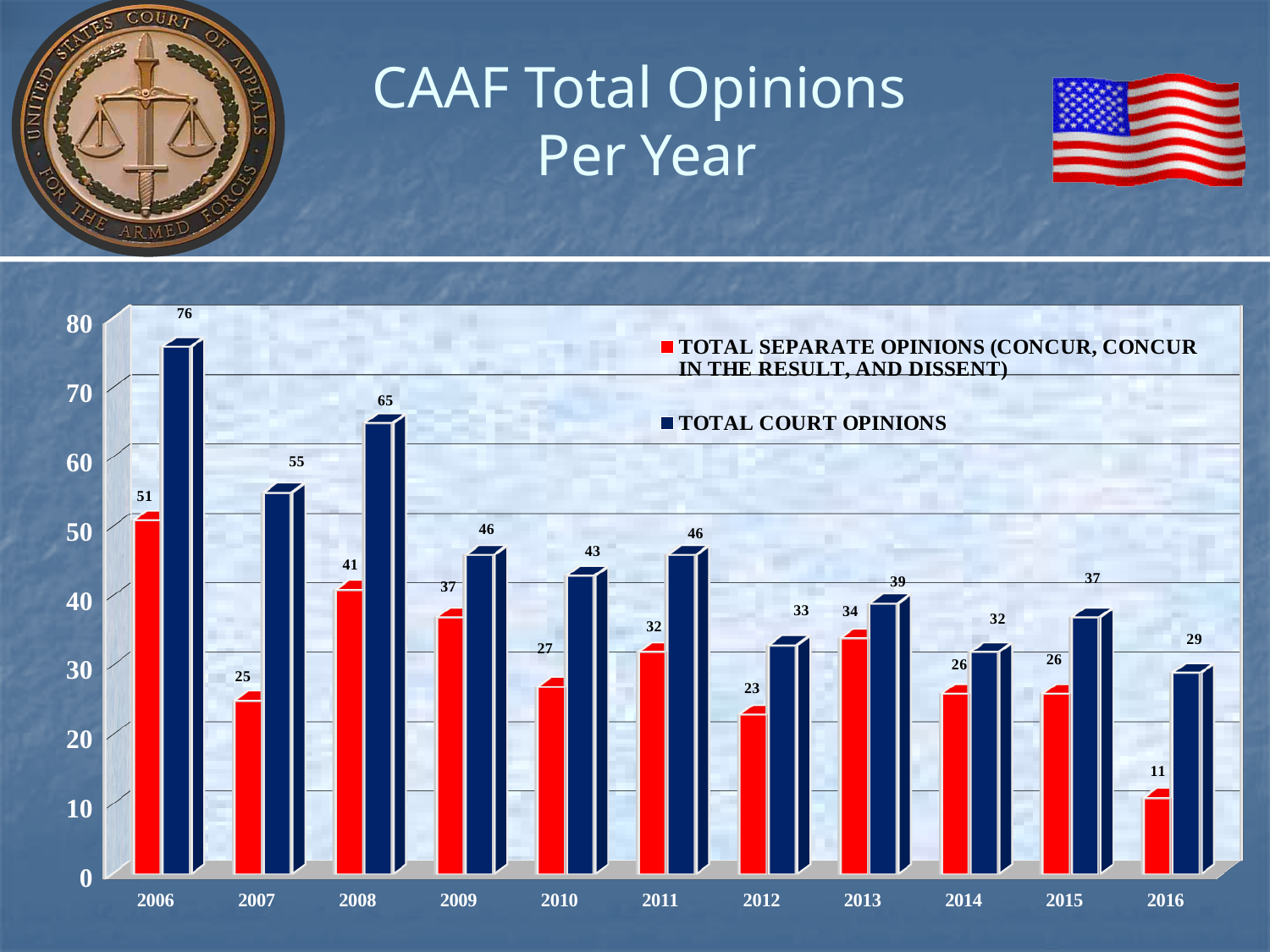
Which is larger: Total Court Opinions in 2010 or Total Court Opinions in 2012? 2010 Do Total Court Opinions generally rise or fall from 2006 to 2016? fall What is the value for Total Separate Opinions in 2016? 11 What kind of chart is shown on the slide? bar chart How many years are shown on the x axis? 11 What is the value for Total Separate Opinions in 2013? 34 What is the difference between Total Court Opinions and Total Separate Opinions in 2008? 24 What colour are the bars for Total Court Opinions? blue Which year has the lowest Total Separate Opinions? 2016 How many series does the legend list? 2 What is the value for Total Court Opinions in 2006? 76 Which year has the highest Total Court Opinions? 2006